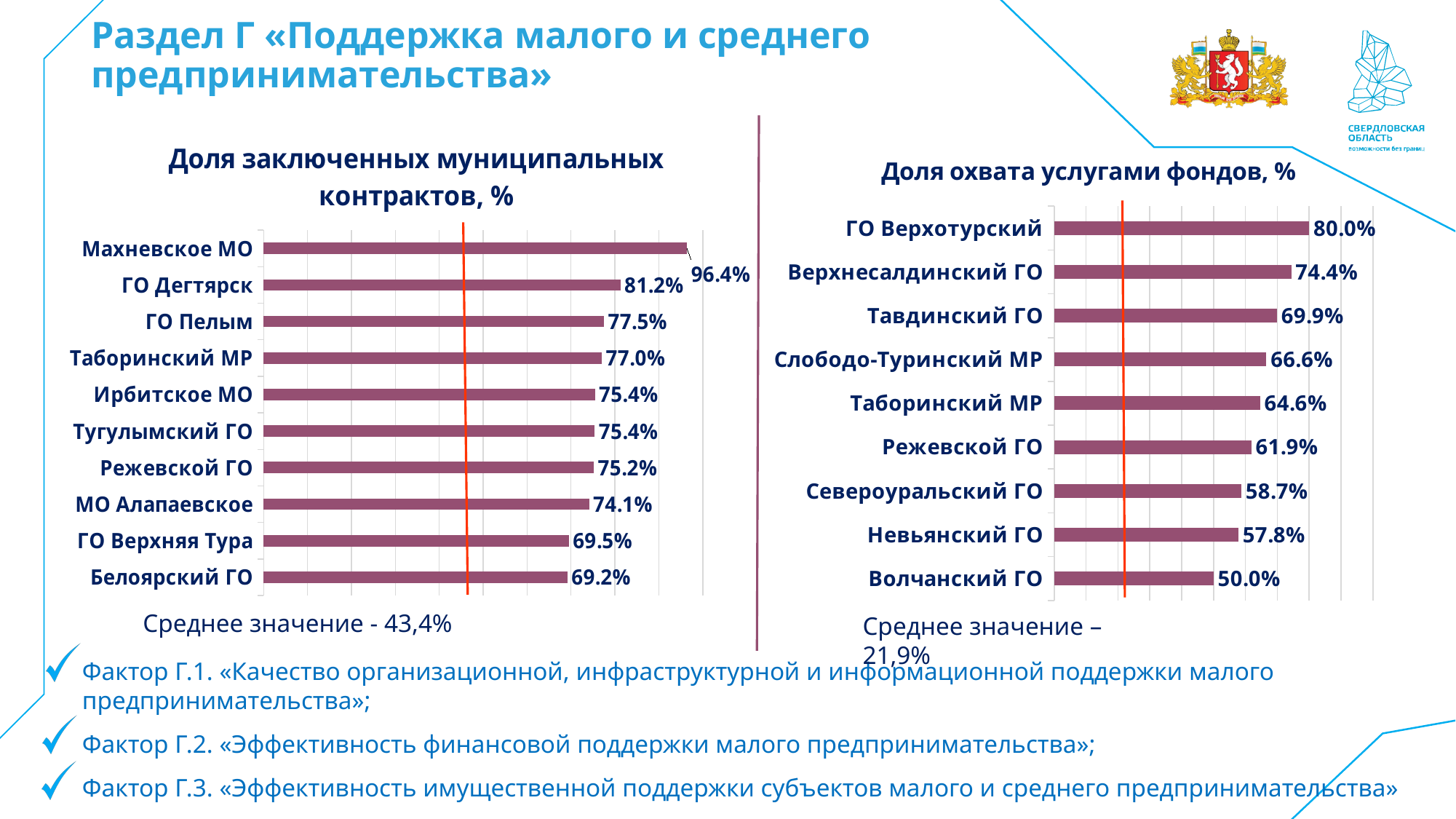
In the chart "Доля заключенных муниципальных контрактов, %", which category has the highest value? Махневское МО In the chart "Доля охвата услугами фондов, %", what is the value for Тавдинский ГО? 69.9% In the chart "Доля заключенных муниципальных контрактов, %", what is the value for ГО Верхняя Тура? 69.5% In the chart "Доля охвата услугами фондов, %", how many categories are shown? 9 In the chart "Доля заключенных муниципальных контрактов, %", how many categories are shown? 10 In the chart "Доля охвата услугами фондов, %", which category has the lowest value? Волчанский ГО What type of chart is "Доля охвата услугами фондов, %"? Bar chart In the chart "Доля заключенных муниципальных контрактов, %", what is the value for ГО Дегтярск? 81.2% In the chart "Доля заключенных муниципальных контрактов, %", which category has the lowest value? Белоярский ГО In the chart "Доля охвата услугами фондов, %", which is larger: Режевской ГО or Невьянский ГО? Режевской ГО In the chart "Доля заключенных муниципальных контрактов, %", what is the difference between Махневское МО and ГО Дегтярск? 15.2% In the chart "Доля охвата услугами фондов, %", which category has the highest value? ГО Верхотурский